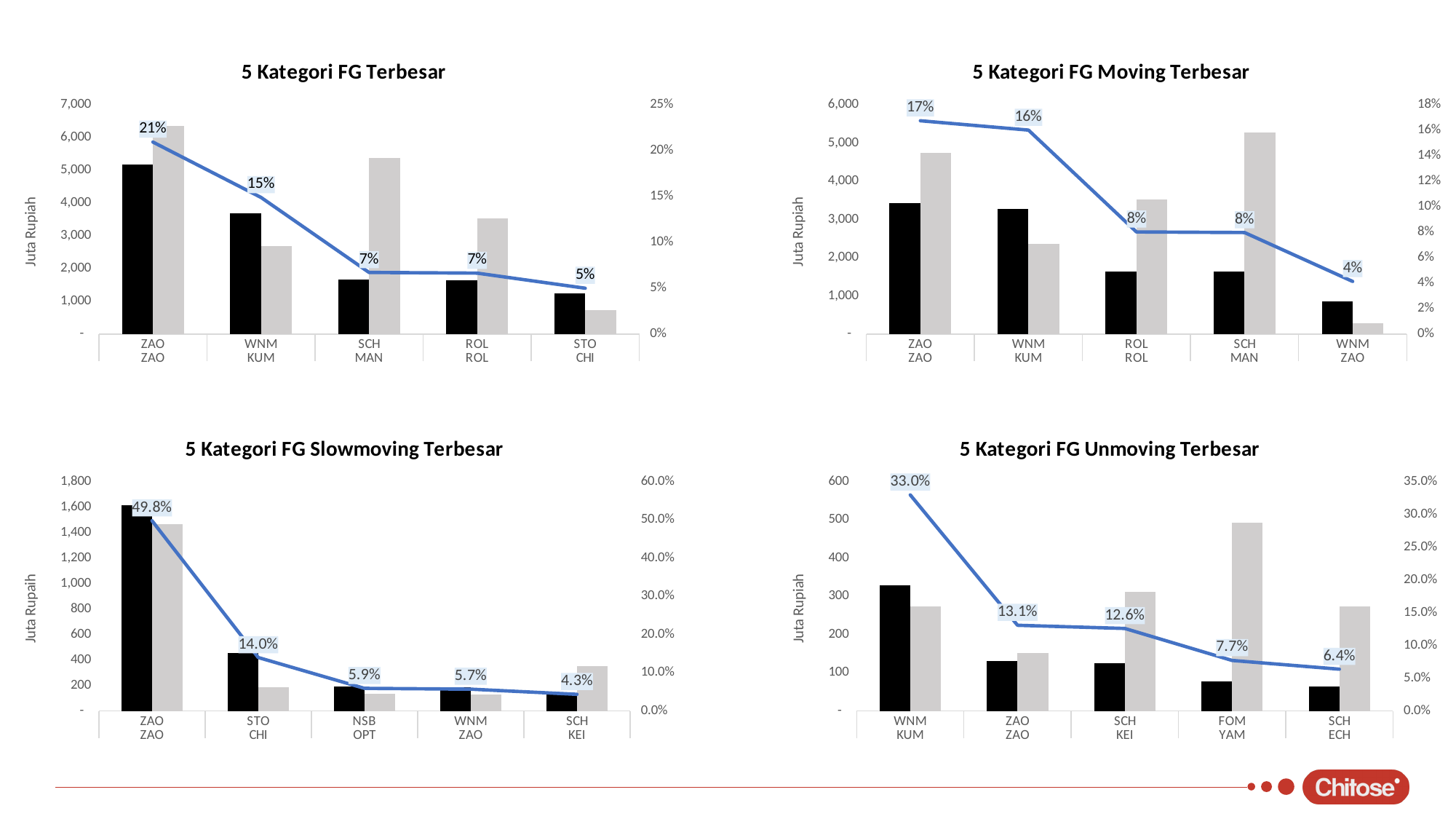
In the chart titled '5 Kategori FG Moving Terbesar', which has a higher line percentage, ZAO ZAO or WNM ZAO? ZAO ZAO In the chart titled '5 Kategori FG Unmoving Terbesar', is the grey bar for FOM YAM greater or less than 400? greater In the chart titled '5 Kategori FG Moving Terbesar', does the line percentage rise or fall from left to right across the categories? fall In the chart titled '5 Kategori FG Slowmoving Terbesar', what percentage is shown on the line for STO CHI? 14.0% In the chart titled '5 Kategori FG Unmoving Terbesar', which category has the highest percentage on the line? WNM KUM In the chart titled '5 Kategori FG Terbesar', what percentage is shown on the line for ZAO ZAO? 21% In the chart titled '5 Kategori FG Unmoving Terbesar', what is the difference between the line percentages for WNM KUM and ZAO ZAO? 19.9% In the chart titled '5 Kategori FG Moving Terbesar', what percentage is shown on the line for WNM KUM? 16% In the chart titled '5 Kategori FG Terbesar', is the black bar for ZAO ZAO greater or less than 4,000 Juta Rupiah? greater In the chart titled '5 Kategori FG Slowmoving Terbesar', which category has the lowest percentage on the line? SCH KEI How many categories are shown on the x axis of the chart titled '5 Kategori FG Slowmoving Terbesar'? 5 What is the label on the left vertical axis of the chart titled '5 Kategori FG Terbesar'? Juta Rupiah